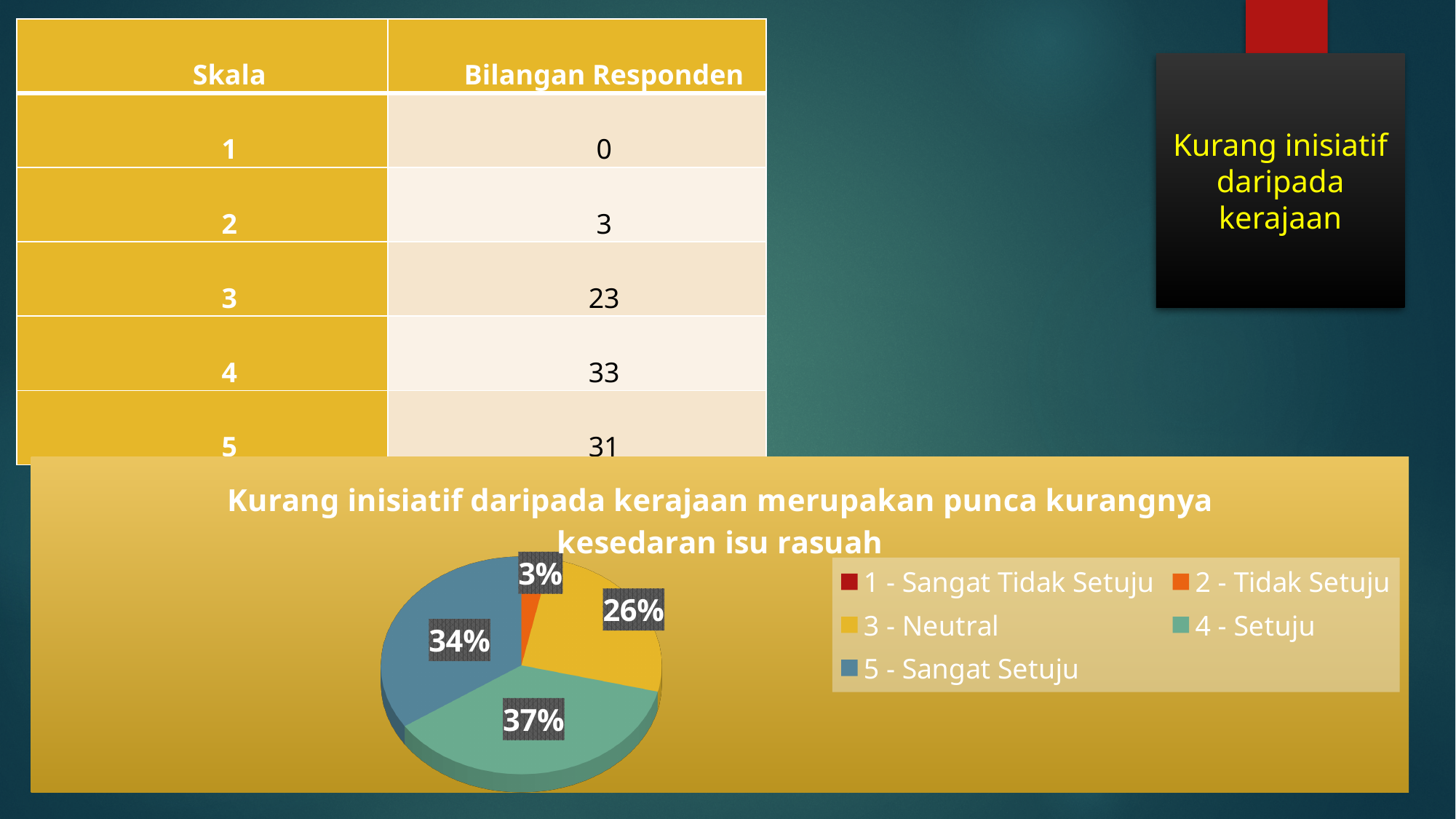
Which category has the largest slice of the pie? 4 - Setuju What kind of chart is shown on the slide? pie chart What share of the pie does the "3 - Neutral" slice represent? 26% Which is larger, the slice for "3 - Neutral" or the slice for "5 - Sangat Setuju"? 5 - Sangat Setuju How many categories does the legend of the pie chart list? 5 What is the difference in percentage points between the "3 - Neutral" slice and the "2 - Tidak Setuju" slice? 23 What share of the pie does the "2 - Tidak Setuju" slice represent? 3% Which legend entry is shown in blue? 5 - Sangat Setuju What share of the pie does the "4 - Setuju" slice represent? 37% What is the title of the pie chart? Kurang inisiatif daripada kerajaan merupakan punca kurangnya kesedaran isu rasuah What is the difference in percentage points between the "4 - Setuju" slice and the "5 - Sangat Setuju" slice? 3